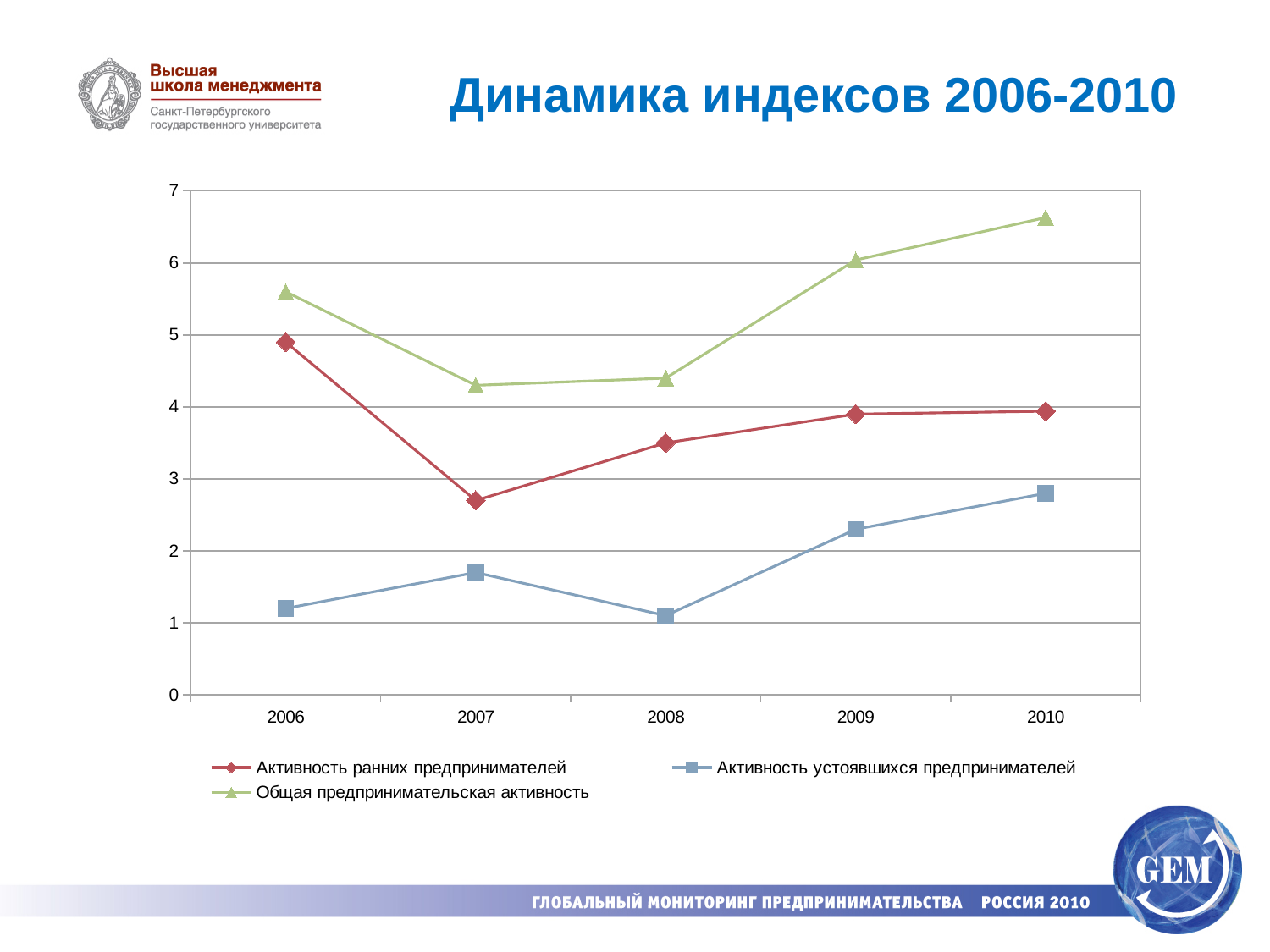
Is the value for Общая предпринимательская активность in 2007 greater or less than 5? less In which year is the value for Общая предпринимательская активность highest? 2010 What is the title of the slide's chart? Динамика индексов 2006-2010 How many series does the legend list? 3 What kind of chart is shown on the slide? line chart Is the value for Активность устоявшихся предпринимателей in 2010 greater or less than 3? less Does the value for Активность устоявшихся предпринимателей rise or fall from 2008 to 2010? rise Is the value for Активность ранних предпринимателей in 2006 greater or less than 4? greater In which year is the value for Активность ранних предпринимателей lowest? 2007 In 2006, which series has the larger value: Активность ранних предпринимателей or Активность устоявшихся предпринимателей? Активность ранних предпринимателей How many years are plotted along the x axis? 5